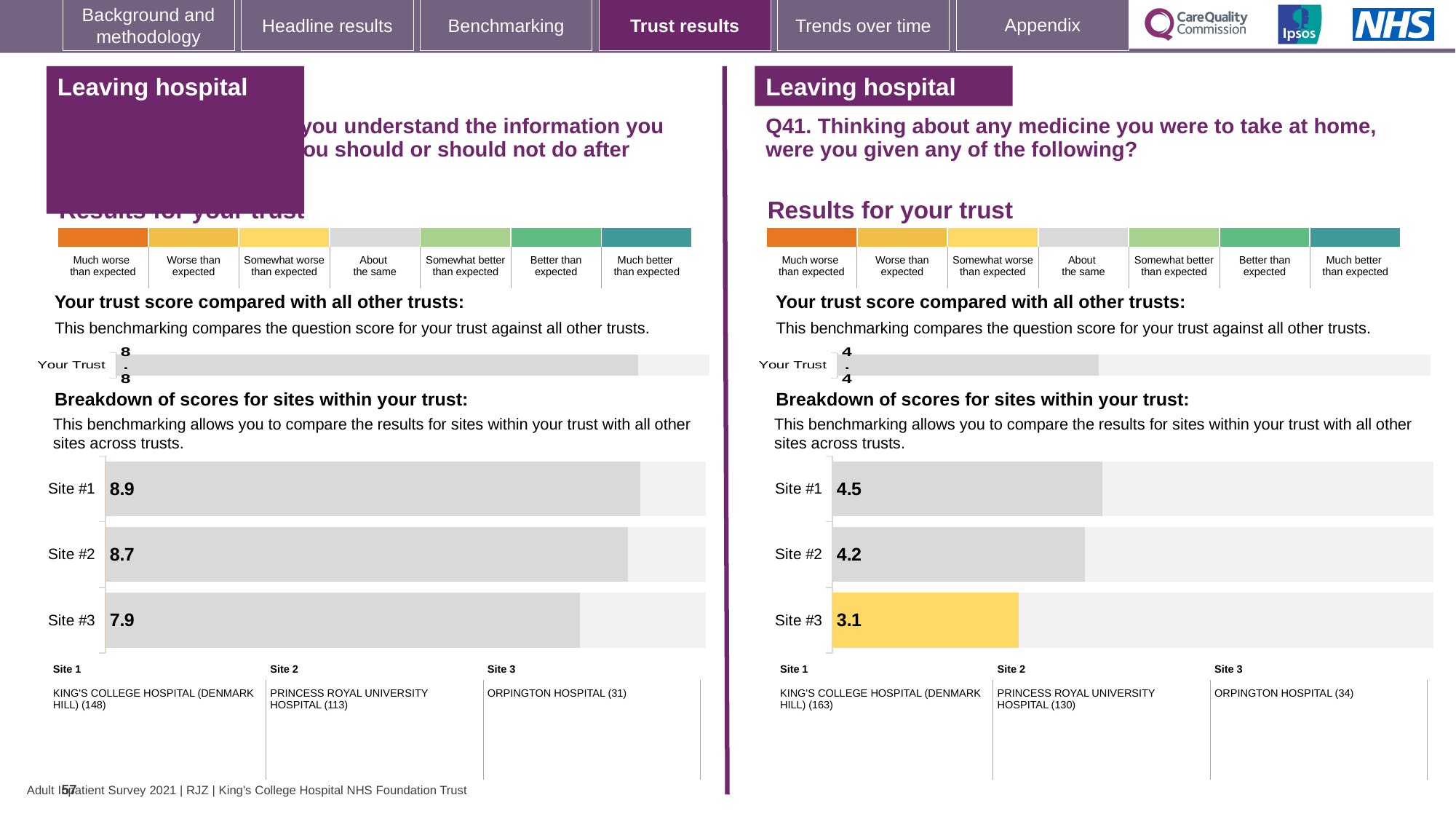
How many sites are shown in the breakdown of scores for sites chart on the left-hand panel? 3 On the right-hand panel's (Q41) breakdown of scores for sites chart, what is the difference between the scores for Site #1 and Site #2? 0.3 On the right-hand panel (Q41), what is the score for Site #3 in the breakdown of scores for sites chart? 3.1 What kind of chart is used for the breakdown of scores for sites on the right-hand panel (Q41)? Bar chart On the left-hand panel, what is the score for Site #2 in the breakdown of scores for sites chart? 8.7 On the left-hand panel's breakdown of scores for sites chart, what is the difference between the scores for Site #1 and Site #3? 1.0 On the left-hand panel, what is the 'Your Trust' score shown in the trust score chart? 8.8 On the right-hand panel (Q41), what is the score for Site #1 in the breakdown of scores for sites chart? 4.5 On the right-hand panel's (Q41) breakdown of scores for sites chart, which has the larger score, Site #2 or Site #3? Site #2 On the left-hand panel's breakdown of scores for sites chart, which site has the highest score? Site #1 On the right-hand panel's (Q41) breakdown of scores for sites chart, which site has the lowest score? Site #3 On the right-hand panel (Q41), what is the 'Your Trust' score shown in the trust score chart? 4.4